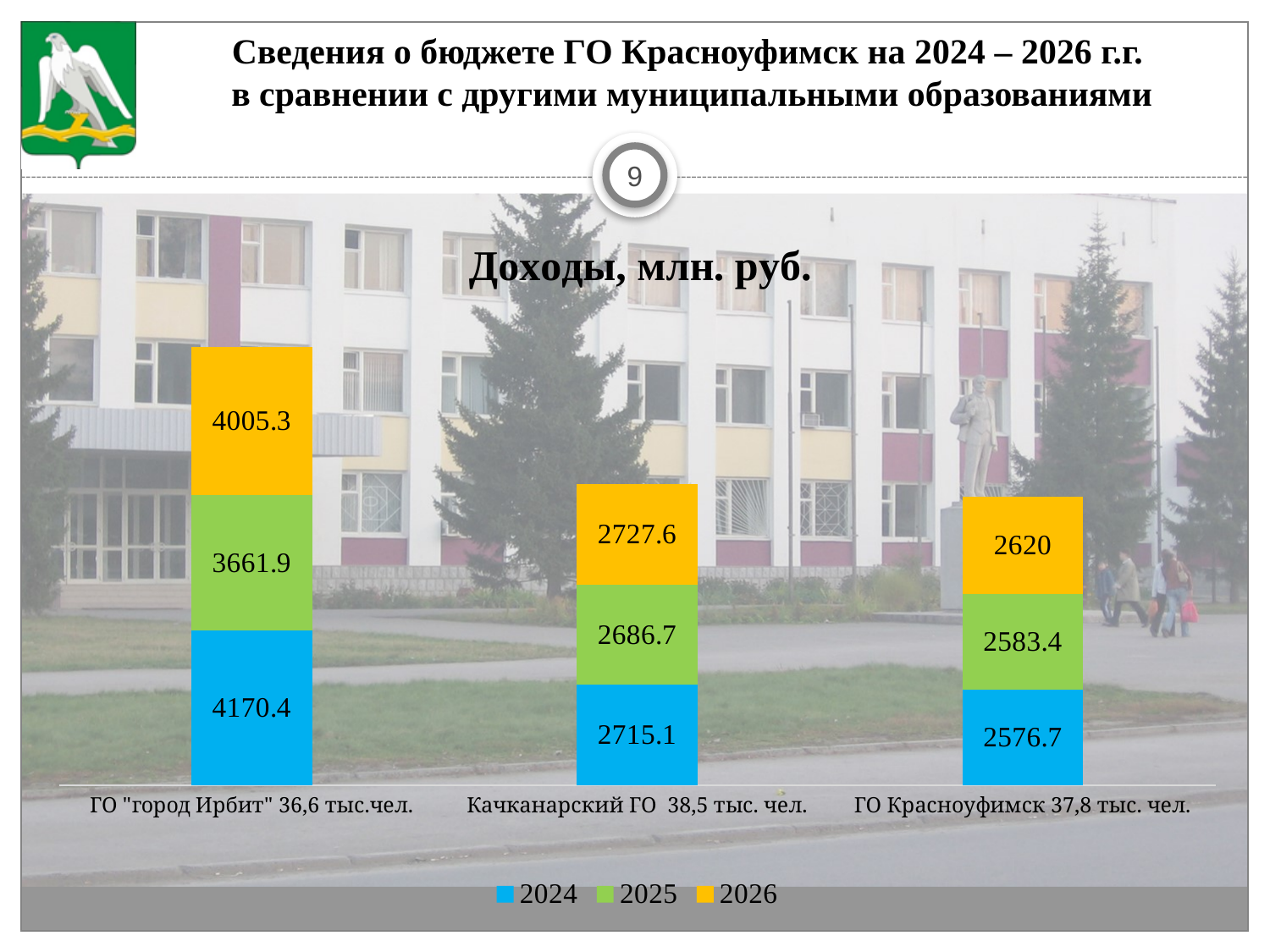
What type of chart is shown on the slide? stacked bar chart What is the 2026 value for ГО Красноуфимск? 2620 What is the 2025 value for Качканарский ГО? 2686.7 Which municipality has the highest 2026 value? ГО "город Ирбит" What is the difference between the 2026 values for ГО "город Ирбит" and ГО Красноуфимск? 1385.3 How many series does the legend list? 3 What is the total of the stacked bar for ГО Красноуфимск across 2024, 2025 and 2026? 7780.1 How many municipalities (categories) are shown on the x axis? 3 What is the title of the chart? Доходы, млн. руб. Which municipality has the lowest 2024 value? ГО Красноуфимск Which is larger: the 2024 value for Качканарский ГО or the 2024 value for ГО Красноуфимск? Качканарский ГО What is the 2024 value for ГО "город Ирбит"? 4170.4